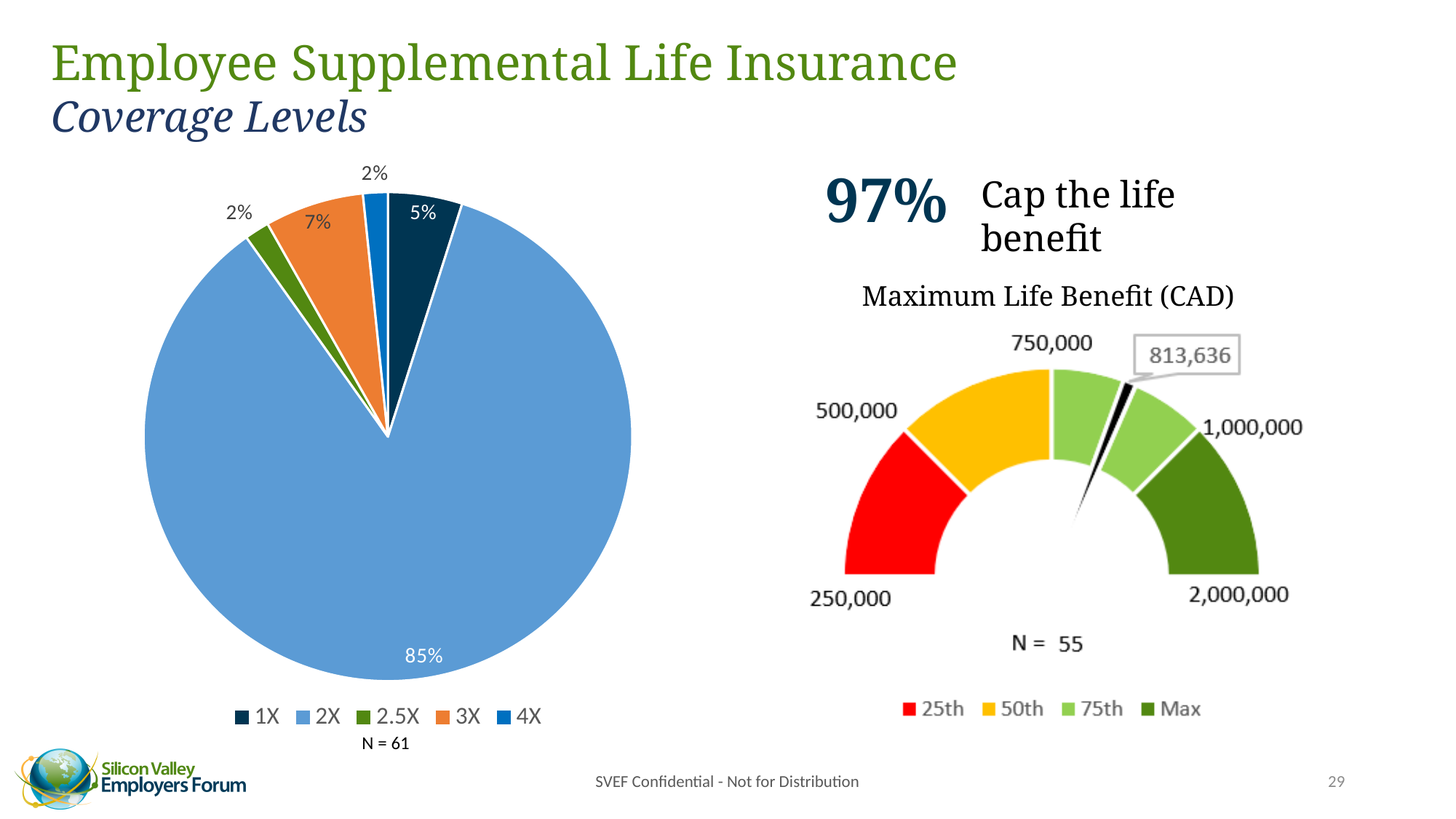
On the pie chart on the left, what percentage is shown for the 3X coverage level? 7% On the pie chart on the left, what is the difference in percentage points between the 3X slice and the 1X slice? 2 On the pie chart on the left, which slice is larger, 1X or 3X? 3X On the pie chart on the left, what is the sample size (N) shown below the legend? N = 61 On the Maximum Life Benefit (CAD) gauge chart, how many entries does the legend list? 4 What type of chart is used on the left side of the slide to show coverage levels? Pie chart On the pie chart on the left, what share of the pie does the 2X coverage level represent? 85% On the Maximum Life Benefit (CAD) gauge chart, what value does the needle point to? 813,636 On the pie chart on the left, what percentage is shown for the 1X coverage level? 5% On the pie chart on the left, how many coverage levels does the legend list? 5 On the pie chart on the left, which coverage level has the largest slice? 2X